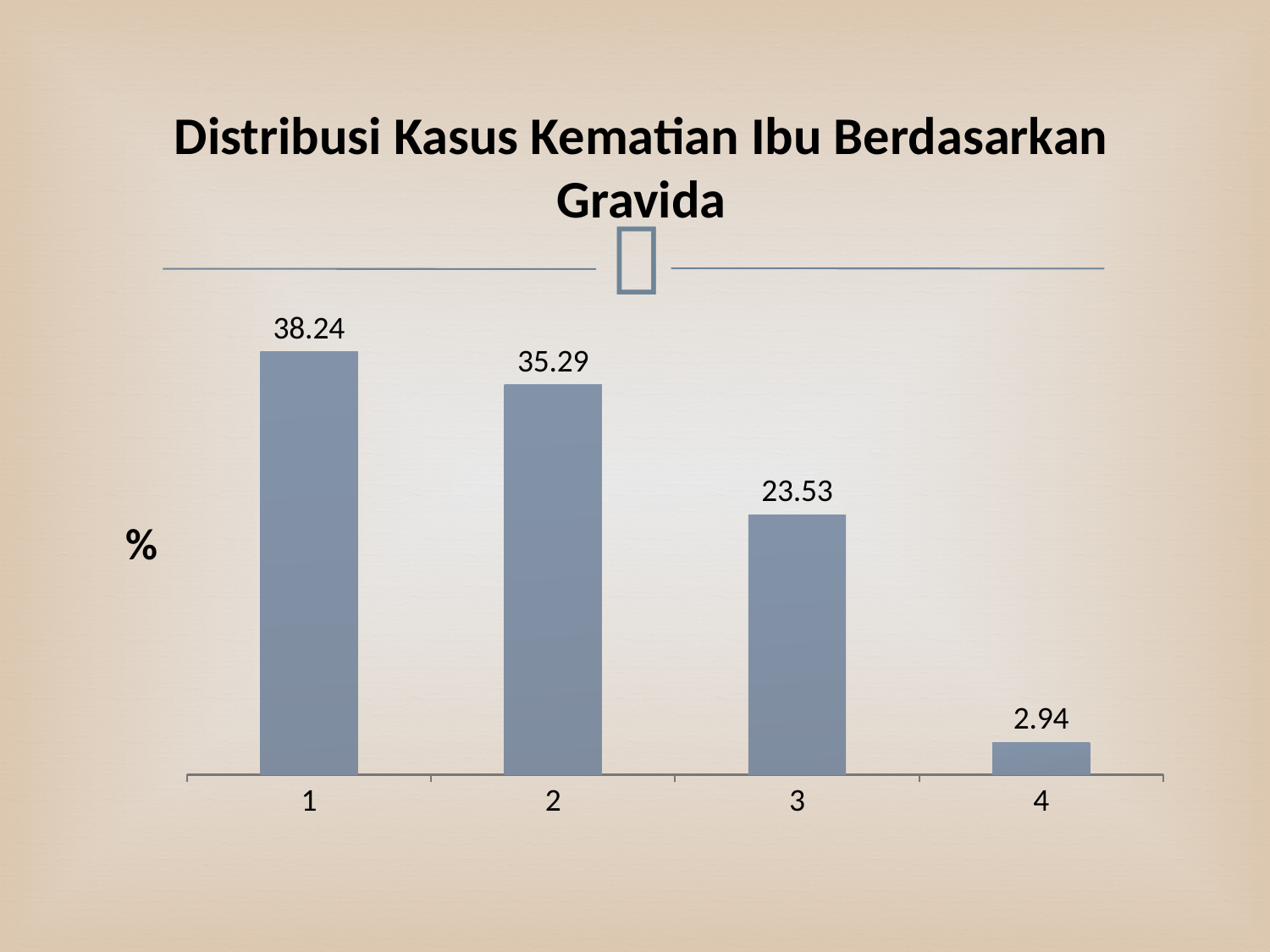
Do the values rise or fall from gravida 1 to gravida 4? fall What kind of chart is shown on the slide? bar chart Which gravida category has the lowest value? 4 What is the difference between the values for gravida 3 and gravida 4? 20.59 What is the value for gravida category 4? 2.94 How many gravida categories are shown on the chart? 4 Which is larger, the value for gravida 2 or gravida 3? 2 What is the value for gravida category 3? 23.53 What is the difference between the values for gravida 1 and gravida 2? 2.95 What is the value for gravida category 1? 38.24 What is the value for gravida category 2? 35.29 Which gravida category has the highest value? 1